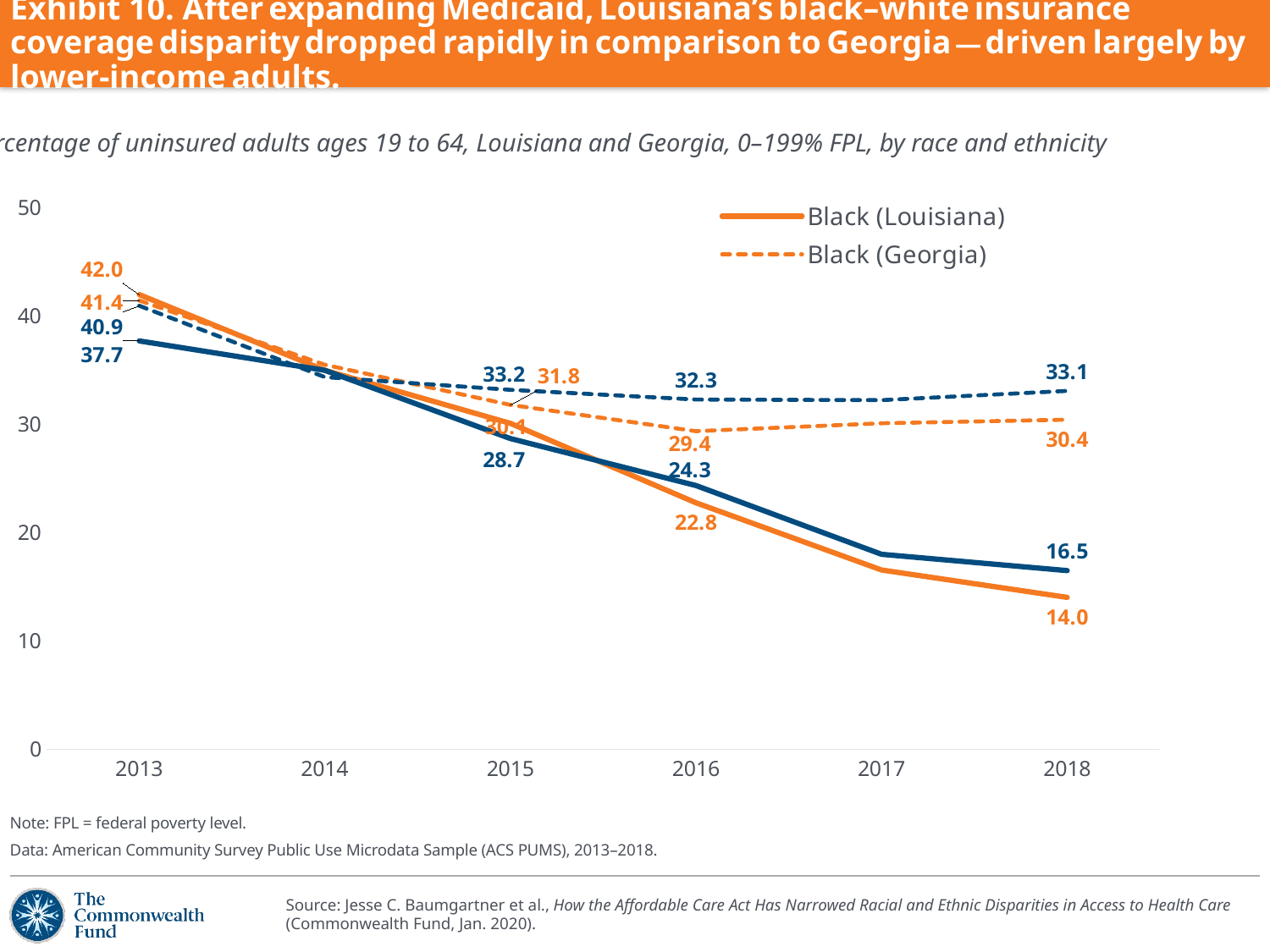
What is the value for Black (Georgia) in 2013? 41.4 Does the Black (Louisiana) line rise or fall from 2013 to 2018? fall How many years are shown on the x axis? 6 In 2018, which is higher: Black (Louisiana) or Black (Georgia)? Black (Georgia) What is the difference between Black (Georgia) and Black (Louisiana) in 2018? 16.4 By how much did the value for Black (Louisiana) fall from 2013 to 2018? 28.0 What kind of chart is shown on the slide? line chart Is the value for Black (Louisiana) in 2017 greater or less than 20? less What is the value for Black (Georgia) in 2018? 30.4 What is the value for Black (Georgia) in 2016? 29.4 What is the value for Black (Louisiana) in 2018? 14.0 What is the value for Black (Louisiana) in 2013? 42.0